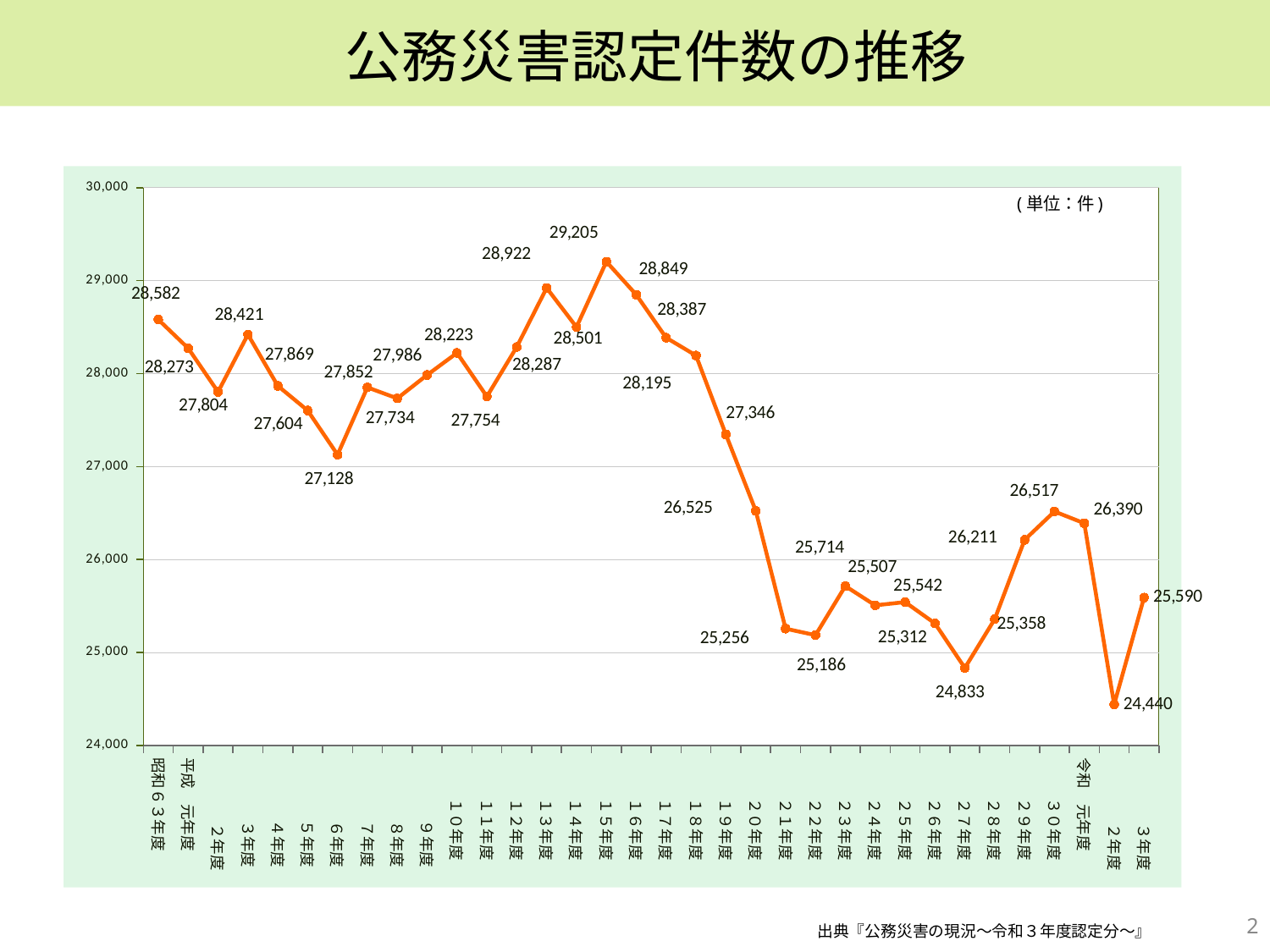
What is the title of the chart? 公務災害認定件数の推移 Is the value for 平成27年度 greater or less than 25,000? less What is the value for 昭和63年度? 28,582 What is the difference between the values for 平成15年度 and 令和2年度? 4,765 What is the value for 令和2年度? 24,440 Which is larger, the value for 平成30年度 or the value for 令和元年度? 平成30年度 Which fiscal year has the highest value? 平成15年度 What is the value for 平成15年度? 29,205 What type of chart is shown on the slide? line chart Does the value rise or fall from 平成18年度 to 平成22年度? fall Which fiscal year has the lowest value? 令和2年度 What is the value for 令和3年度? 25,590